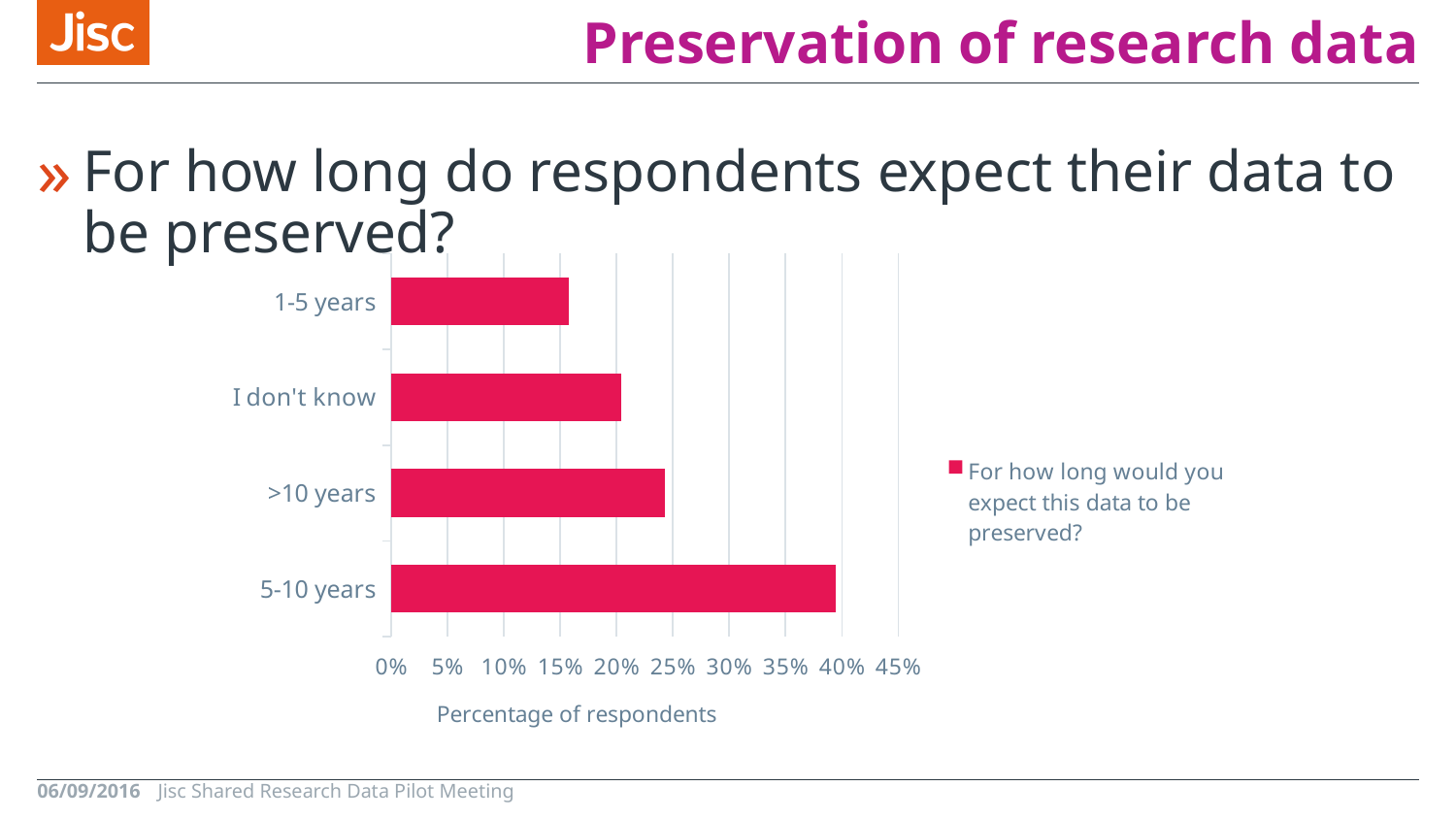
Which category has the highest percentage of respondents? 5-10 years Which category has the lowest percentage of respondents? 1-5 years What is the legend entry for the series shown in the chart? For how long would you expect this data to be preserved? How many series does the legend list? 1 What kind of chart is shown on the slide? Bar chart How many categories are plotted in the chart? 4 What is the title of the horizontal axis? Percentage of respondents Which has a larger value, >10 years or I don't know? >10 years Is the value for 5-10 years greater or less than 35%? greater Is the value for >10 years greater or less than 20%? greater Is the value for 1-5 years greater or less than 20%? less